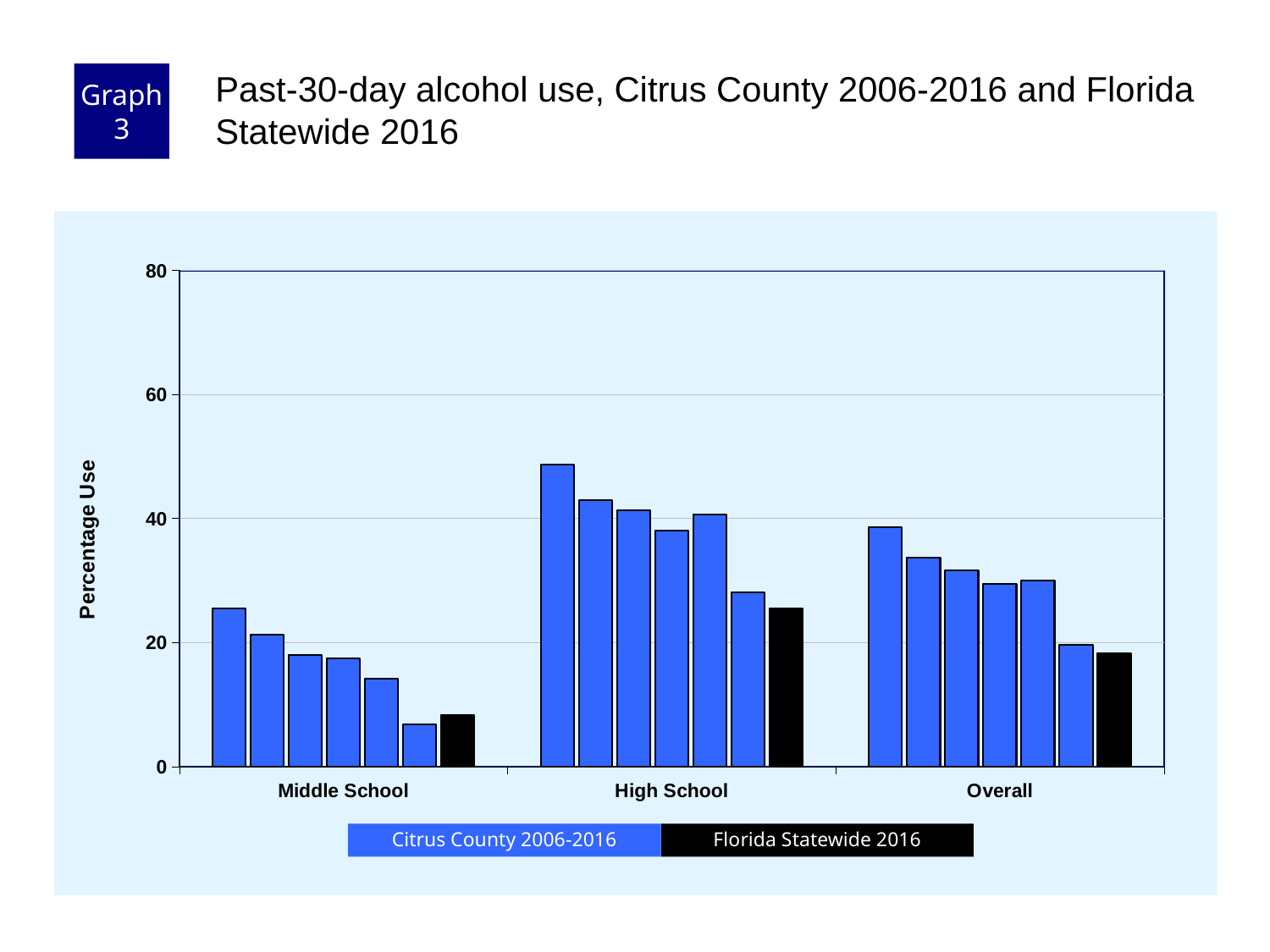
Which colour represents Florida Statewide 2016 in the legend? black How many series does the legend list? 2 Is the tallest Citrus County bar for High School greater or less than 40? greater Is the Florida Statewide 2016 value for High School greater or less than 20? greater What kind of chart is shown on the slide? bar chart Which category has the shortest bars overall? Middle School Is the Florida Statewide 2016 value for Middle School greater or less than 20? less Do the Citrus County 2006-2016 bars within the Middle School group generally rise or fall from left to right? fall Which is larger, the Florida Statewide 2016 value for High School or for Middle School? High School How many categories are shown on the x axis? 3 Which category has the tallest bars overall? High School What is the label of the y axis? Percentage Use